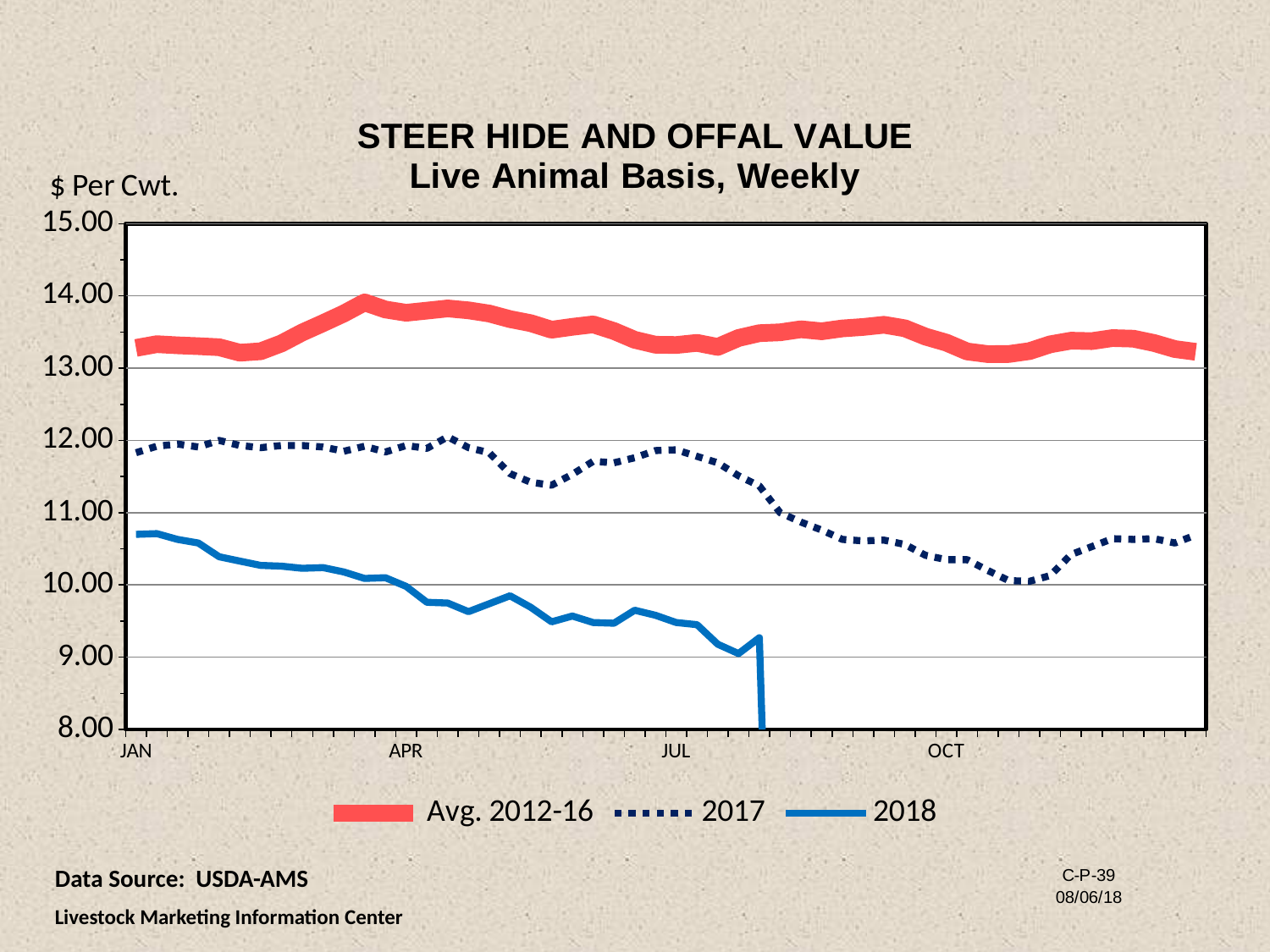
What unit is shown on the y axis label? $ Per Cwt. What kind of chart is shown on the slide? Line chart Is the value for 2018 in JAN greater or less than 10.00? greater Is the value for 2017 in OCT greater or less than 11.00? less Is the value for 2017 in APR greater or less than 11.00? greater Does the 2018 line rise or fall from JAN to JUL? fall Which series has the lowest value in JAN? 2018 How many series does the legend list? 3 Which series has the highest value in JAN? Avg. 2012-16 What is the title of the chart? STEER HIDE AND OFFAL VALUE Live Animal Basis, Weekly